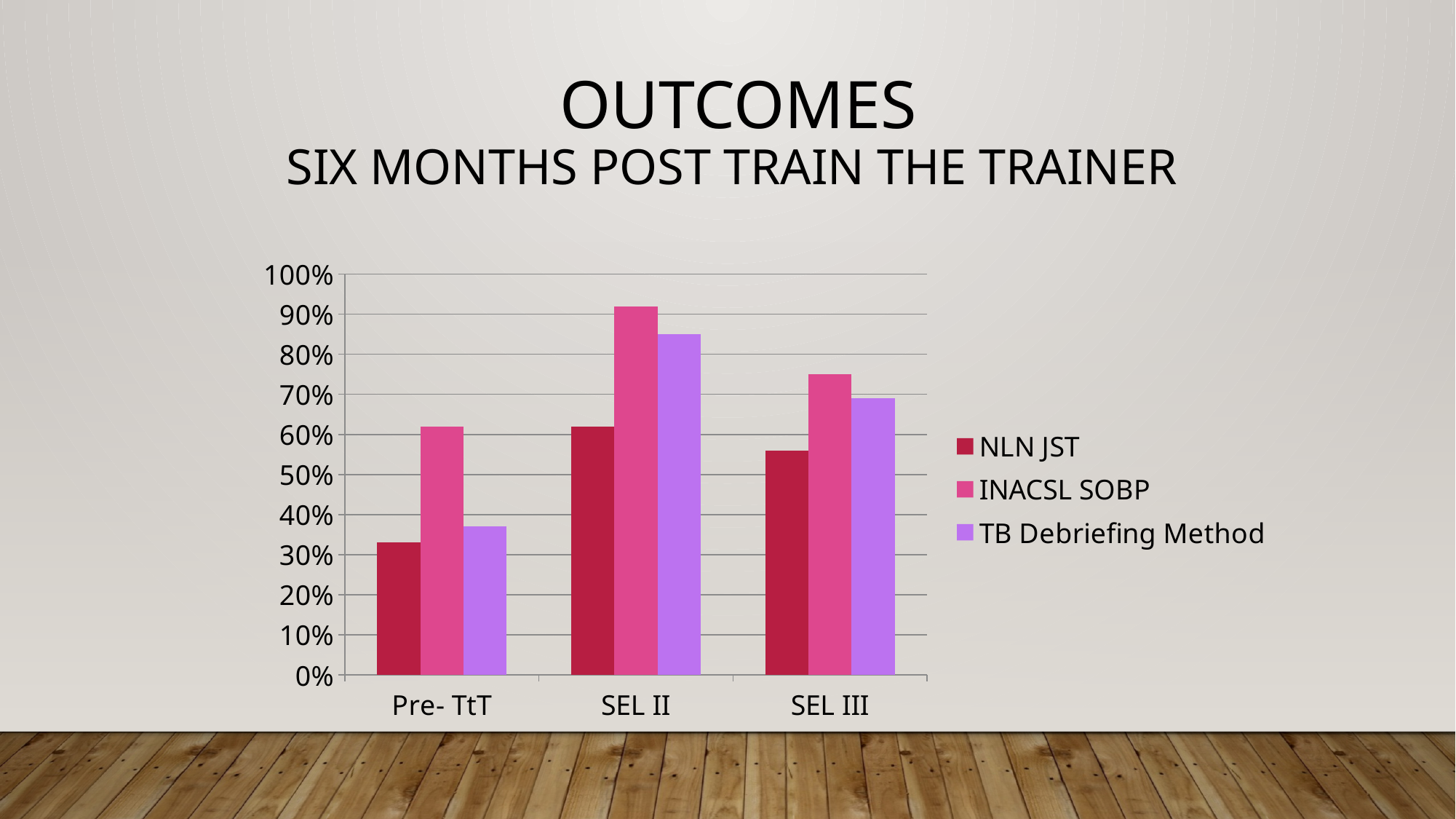
Which is larger in SEL III: the value for NLN JST or the value for TB Debriefing Method? TB Debriefing Method Which is larger for INACSL SOBP: the value in Pre- TtT or the value in SEL III? SEL III In which category does INACSL SOBP reach its highest value? SEL II Which series has the highest value in the SEL II category? INACSL SOBP Is the value for TB Debriefing Method in SEL III greater or less than 60%? greater Is the value for NLN JST in Pre- TtT greater or less than 40%? less How many categories are shown on the x axis? 3 Is the value for INACSL SOBP in SEL II greater or less than 90%? greater How many series does the legend list? 3 What kind of chart is shown on the slide? bar chart Which series has the lowest value in the Pre- TtT category? NLN JST What is the title of the slide containing the chart? Outcomes Six Months Post Train the Trainer